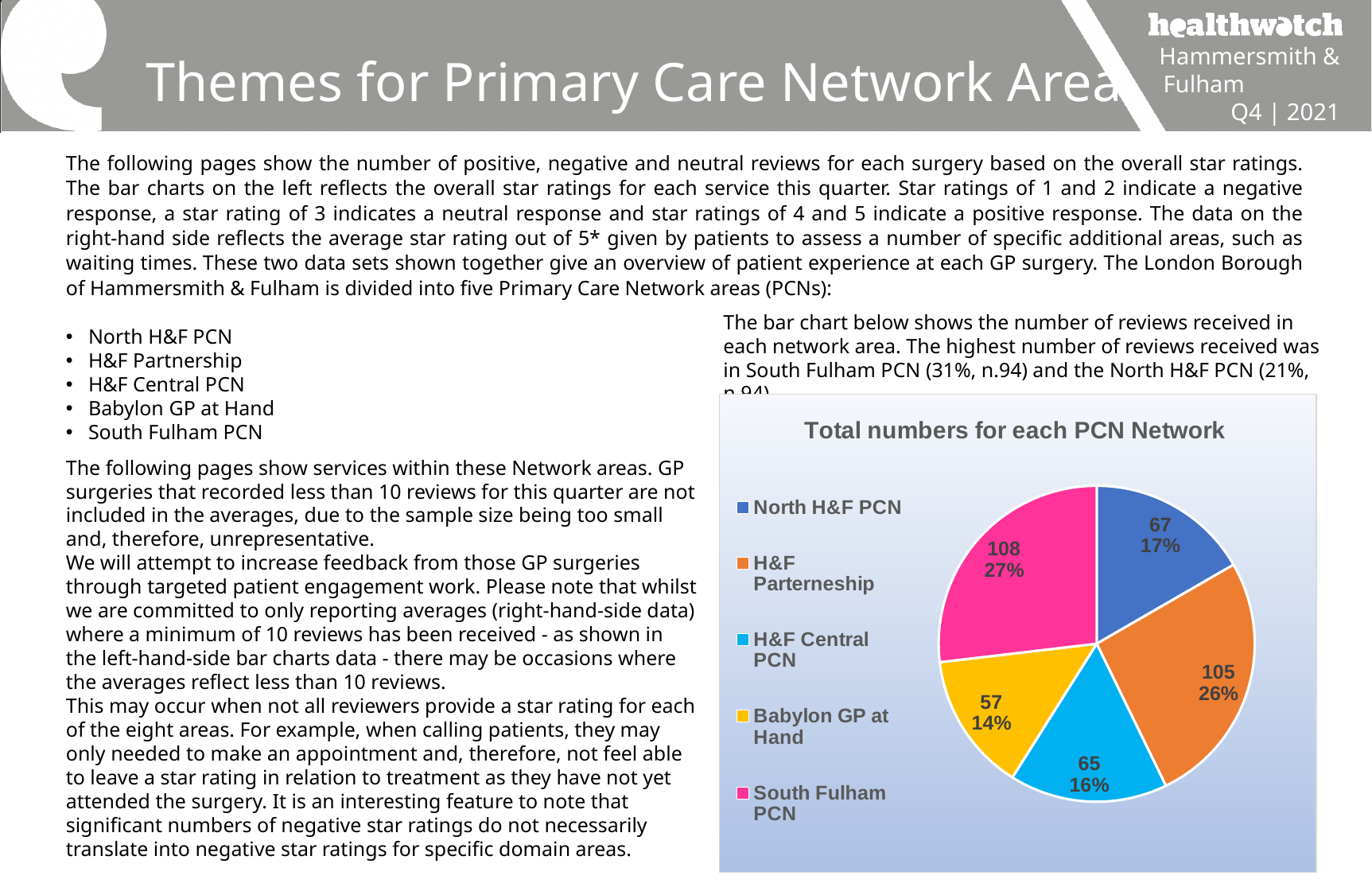
What is the title of the chart? Total numbers for each PCN Network What is the value for North H&F PCN? 67 What kind of chart is shown on the slide? pie chart Which PCN has the lowest number of reviews? Babylon GP at Hand What share of the pie does H&F Parternership represent? 26% What is the value for H&F Central PCN? 65 What is the value for Babylon GP at Hand? 57 What share of the pie does South Fulham PCN represent? 27% How many slices does the pie chart have? 5 What is the difference between the values for South Fulham PCN and Babylon GP at Hand? 51 Which PCN has the highest number of reviews? South Fulham PCN Which is larger, the value for North H&F PCN or the value for H&F Central PCN? North H&F PCN